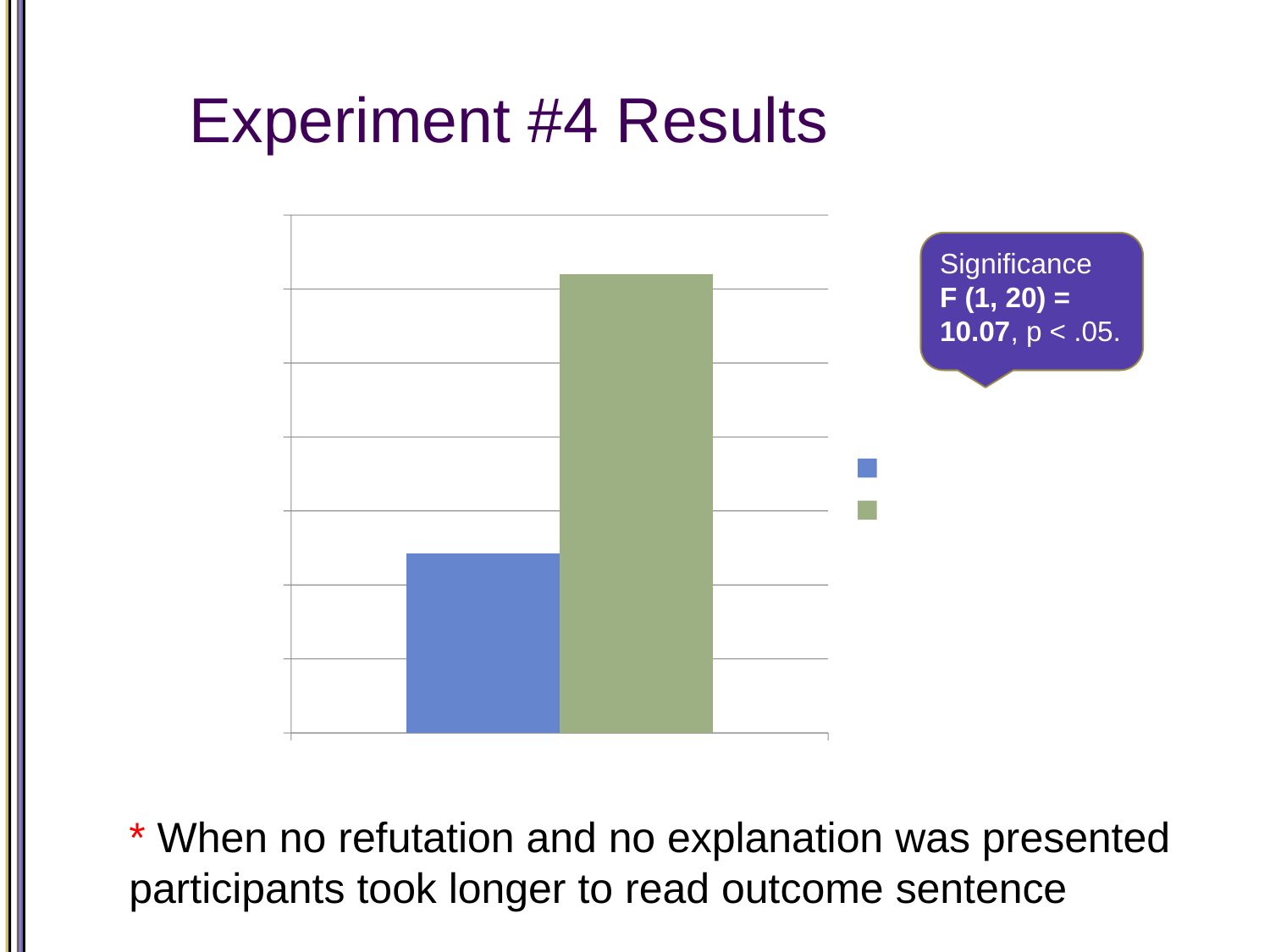
What colour is the shortest bar in the chart? blue What colour is the tallest bar in the chart? green Are numeric data labels printed on the bars of the chart? no What kind of chart is shown on the slide? bar chart Which bar is taller, the blue bar or the green bar? the green bar How many entries does the chart's legend list? 2 How many bars are plotted in the chart? 2 What colours are the two legend swatches next to the chart? blue and green